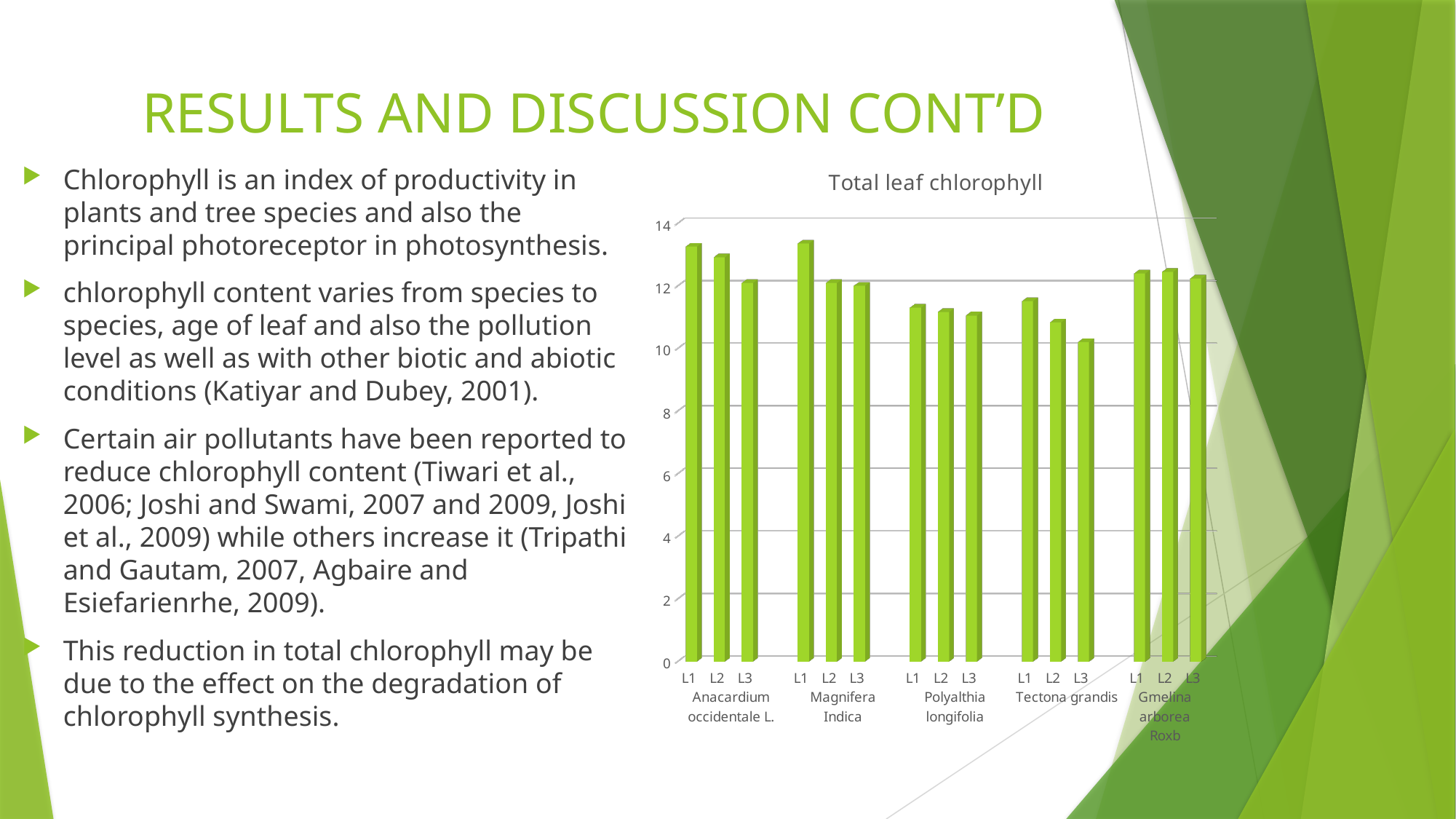
Which is larger, the value for Anacardium occidentale L. L1 or the value for Tectona grandis L3? Anacardium occidentale L. L1 What colour are the bars in the chart? green How many bars are plotted in the chart in total? 15 What kind of chart is shown on the slide? bar chart How many tree species are shown along the x axis of the chart? 5 What is the title of the chart? Total leaf chlorophyll Is the value for Anacardium occidentale L. L1 greater or less than 12? greater Which bar has the lowest value in the chart? Tectona grandis L3 For Tectona grandis, do the values rise or fall from L1 to L3? fall Is the value for Magnifera Indica L1 greater or less than 12? greater Is the value for Polyalthia longifolia L3 greater or less than 12? less